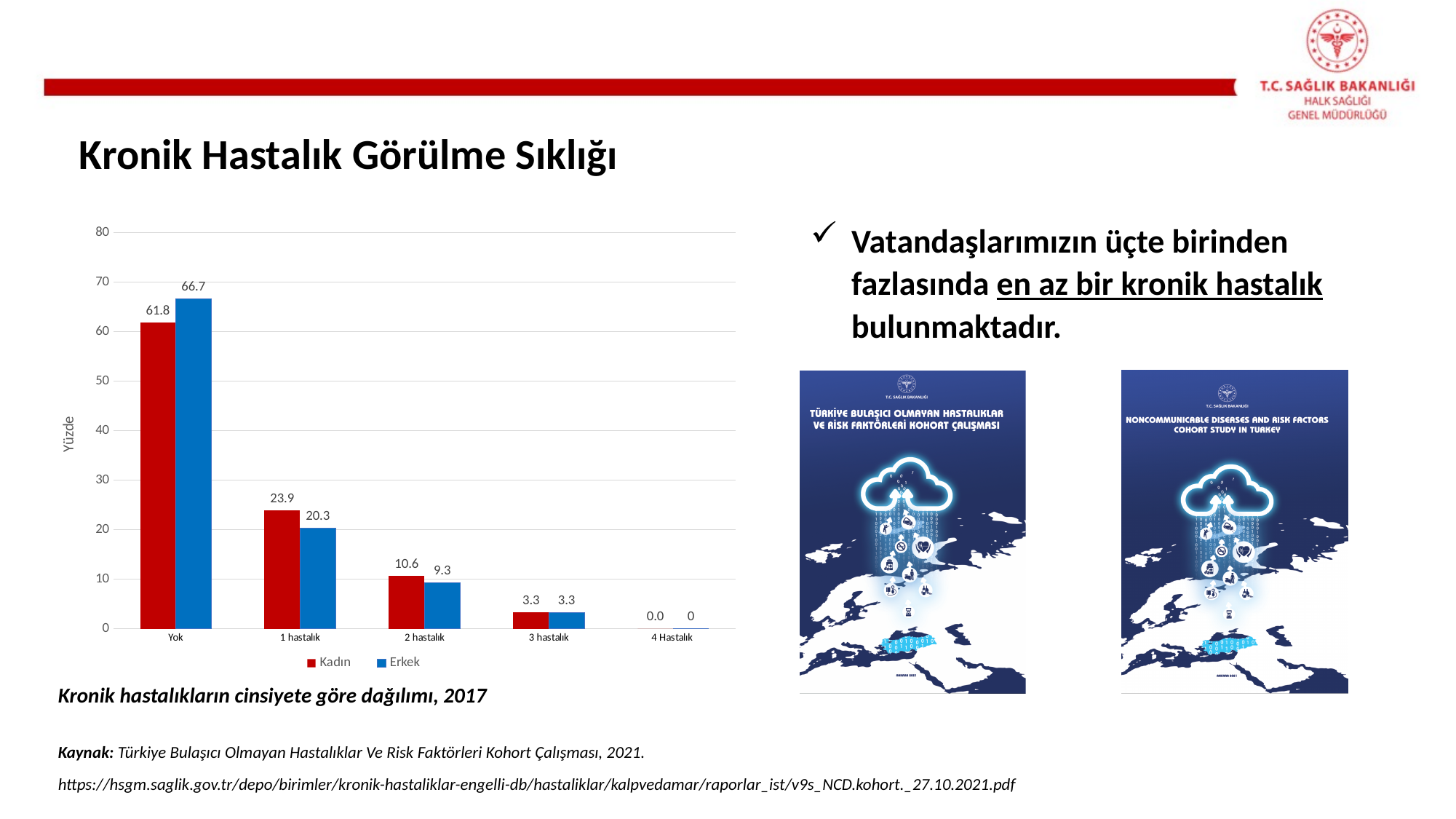
How many categories are shown on the x axis? 5 How many series does the legend list? 2 What is the label of the y axis? Yüzde Which category has the highest value for Erkek? Yok Which category has the lowest value for Kadın? 4 Hastalık What kind of chart is shown on the slide? Bar chart What is the value for Kadın in the 1 hastalık category? 23.9 What is the value for Erkek in the 2 hastalık category? 9.3 What is the difference between the Erkek and Kadın values in the Yok category? 4.9 What is the value for Erkek in the Yok category? 66.7 What is the value for Kadın in the Yok category? 61.8 In the 1 hastalık category, which series has the larger value, Kadın or Erkek? Kadın